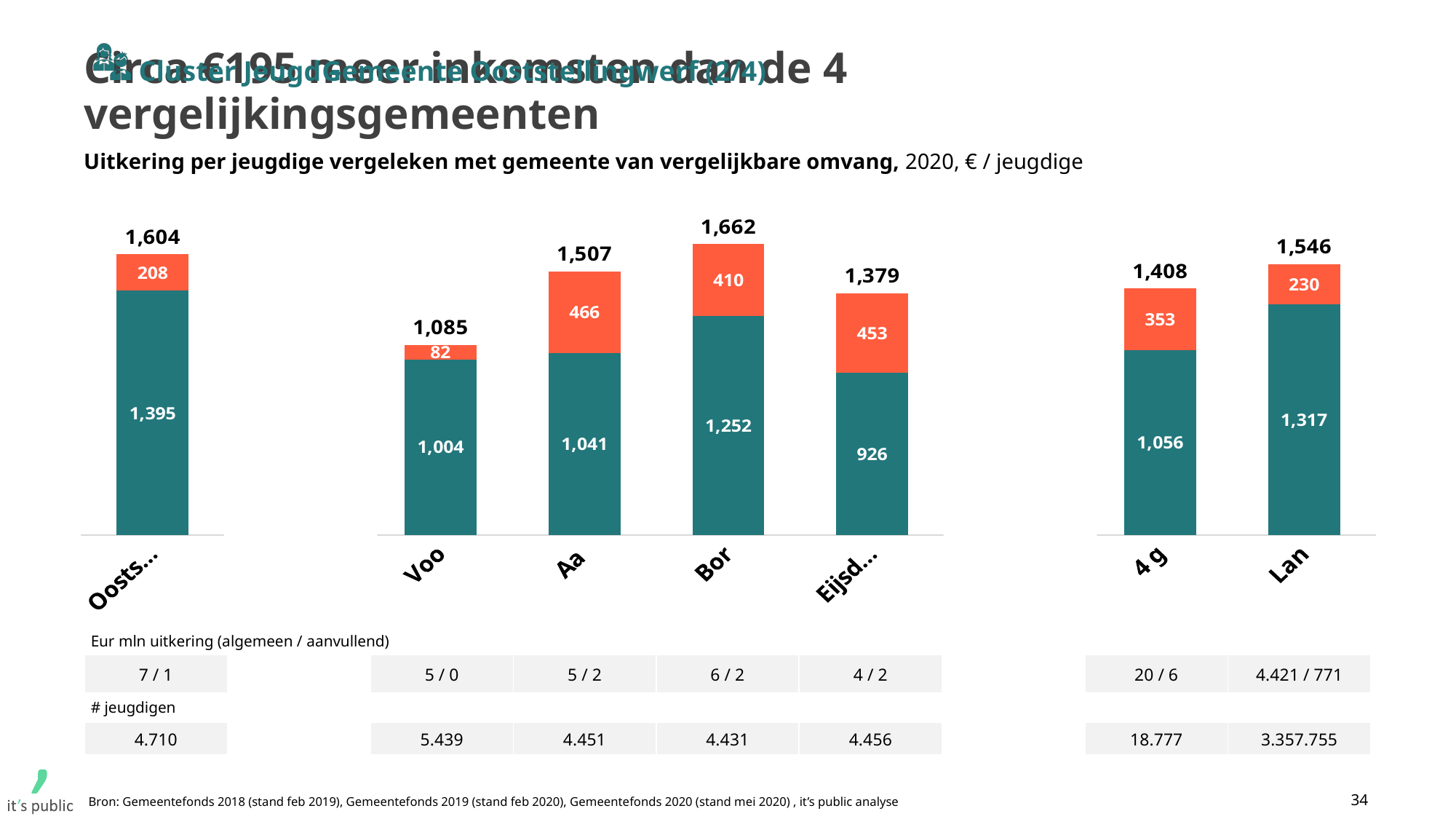
What is the value of the orange (top) segment of the first bar (Oosts...)? 208 What is the total value shown above the bar labelled Bor? 1,662 How many bars are shown in the chart? 7 Which has a larger orange (top) segment, the bar labelled Aa or the bar labelled 4 g? Aa Which bar has the lowest total value? Voo What is the value of the orange (top) segment of the bar labelled Aa? 466 What is the value of the teal (bottom) segment of the bar labelled Lan? 1,317 What is the total value shown above the bar labelled Voo? 1,085 Which bar has the highest total value? Bor What kind of chart is shown on the slide? Stacked bar chart What is the difference between the total values of the bars labelled Bor and Voo? 577